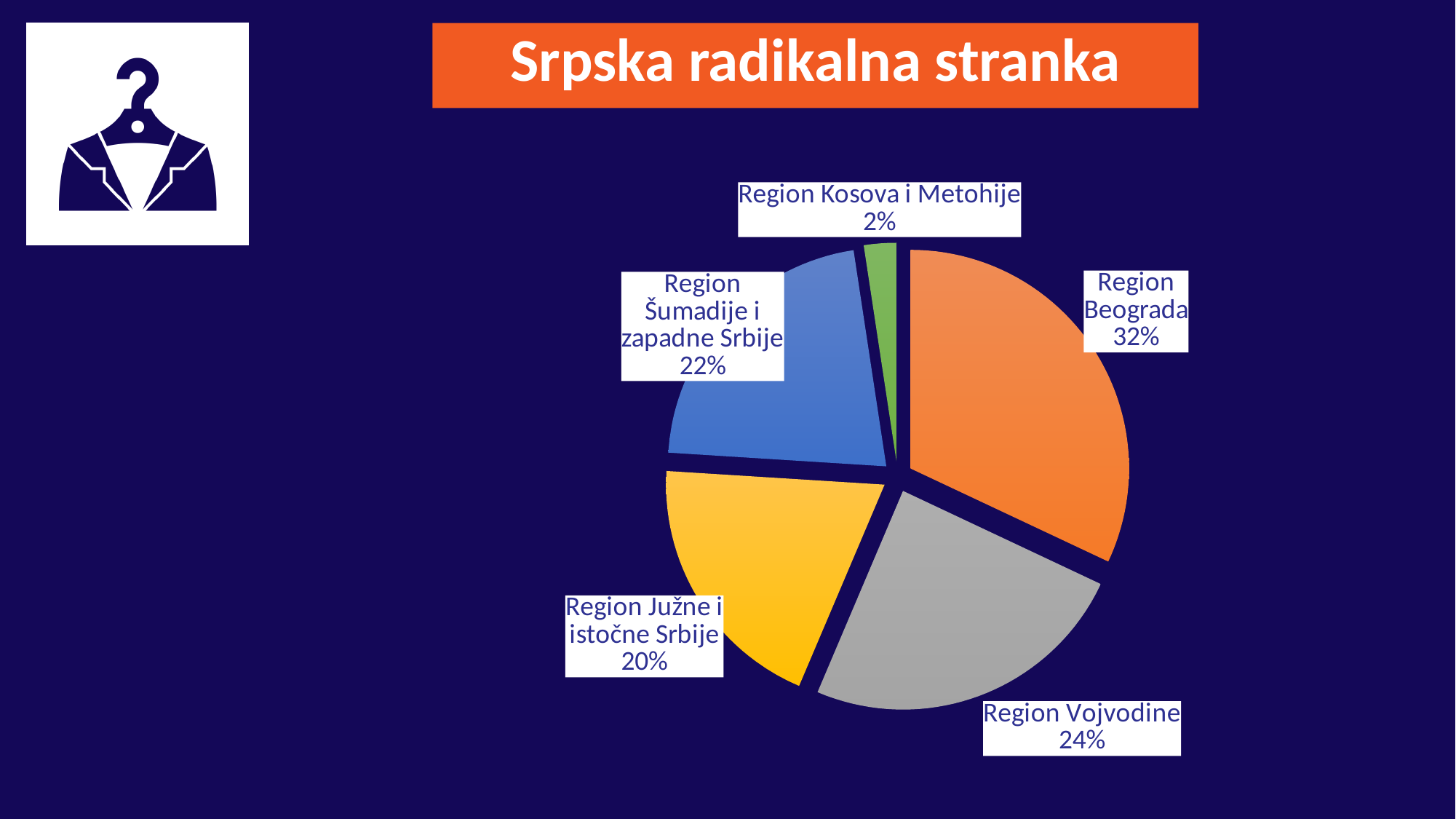
Which region has the largest slice of the pie? Region Beograda Which region has the smallest slice of the pie? Region Kosova i Metohije Which is larger, the share for Region Šumadije i zapadne Srbije or the share for Region Južne i istočne Srbije? Region Šumadije i zapadne Srbije What share of the pie does Region Beograda have? 32% What is the value shown for Region Kosova i Metohije? 2% How many slices does the pie chart have? 5 What is the value shown for Region Šumadije i zapadne Srbije? 22% What is the title shown above the chart? Srpska radikalna stranka What is the difference between the shares of Region Beograda and Region Vojvodine? 8% What is the value shown for Region Južne i istočne Srbije? 20% What kind of chart is shown on the slide? Pie chart What is the value shown for Region Vojvodine? 24%